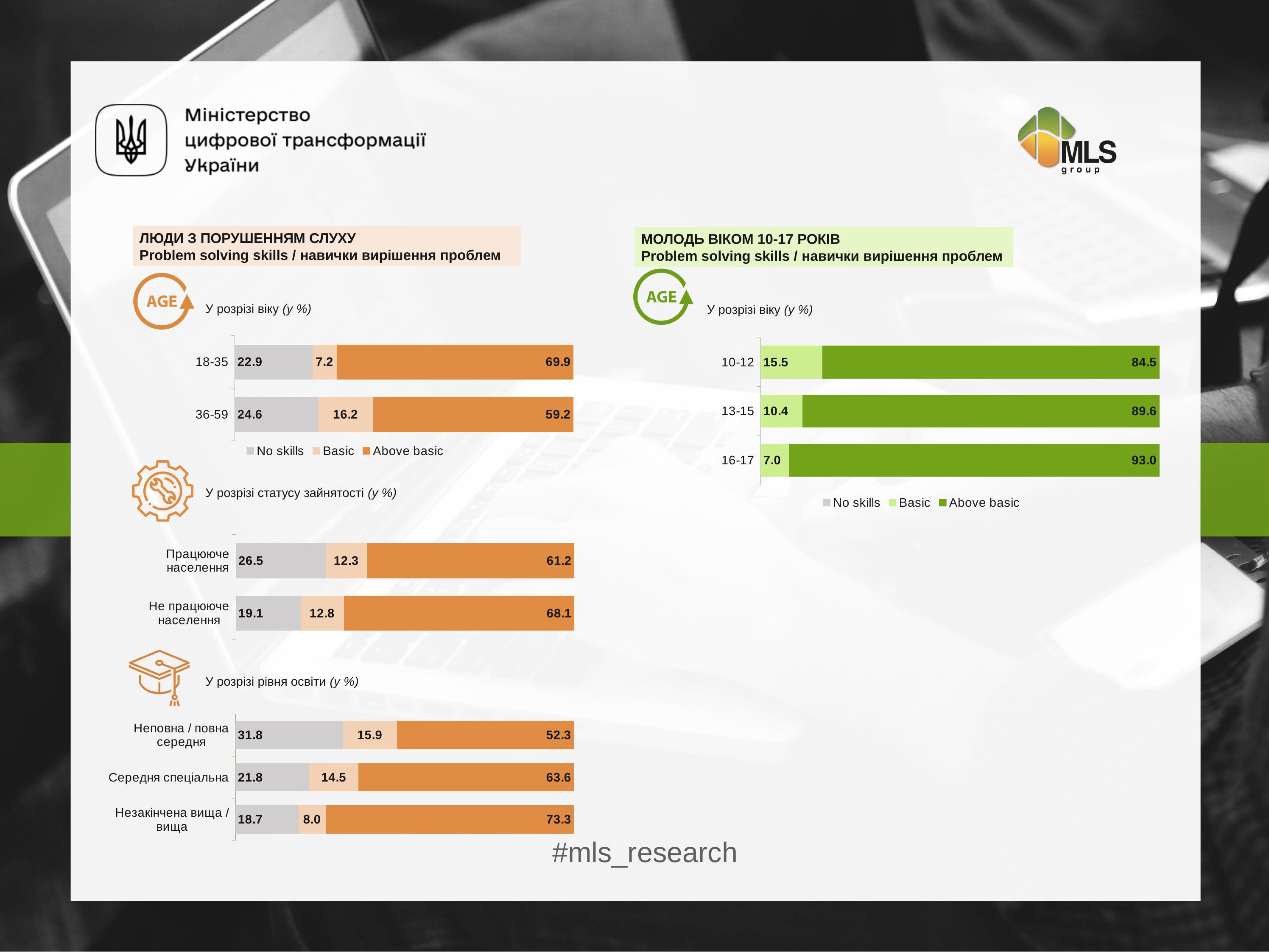
In the left-hand age chart (ЛЮДИ З ПОРУШЕННЯМ СЛУХУ, У розрізі віку), what is the No skills value for the 36-59 group? 24.6 In the right-hand chart (МОЛОДЬ ВІКОМ 10-17 РОКІВ, У розрізі віку), how many age groups are shown? 3 In the left-hand age chart (ЛЮДИ З ПОРУШЕННЯМ СЛУХУ, У розрізі віку), what is the Above basic value for the 18-35 group? 69.9 How many series does the legend of the right-hand chart (МОЛОДЬ ВІКОМ 10-17 РОКІВ) list? 3 In the education level chart (У розрізі рівня освіти) on the left, what is the difference between the Above basic values for Незакінчена вища / вища and Середня спеціальна? 9.7 In the right-hand chart (МОЛОДЬ ВІКОМ 10-17 РОКІВ, У розрізі віку), what is the Basic value for the 13-15 group? 10.4 In the right-hand chart (МОЛОДЬ ВІКОМ 10-17 РОКІВ, У розрізі віку), which age group has the highest Above basic value? 16-17 In the education level chart (У розрізі рівня освіти) on the left, which category has the lowest Above basic value? Неповна / повна середня In the employment status chart (У розрізі статусу зайнятості) on the left, what is the Basic value for Працююче населення? 12.3 In the right-hand chart (МОЛОДЬ ВІКОМ 10-17 РОКІВ, У розрізі віку), what is the difference between the Above basic values for 16-17 and 10-12? 8.5 In the education level chart (У розрізі рівня освіти) on the left, what is the No skills value for Незакінчена вища / вища? 18.7 In the employment status chart (У розрізі статусу зайнятості) on the left, which group has the larger Above basic value: Працююче населення or Не працююче населення? Не працююче населення